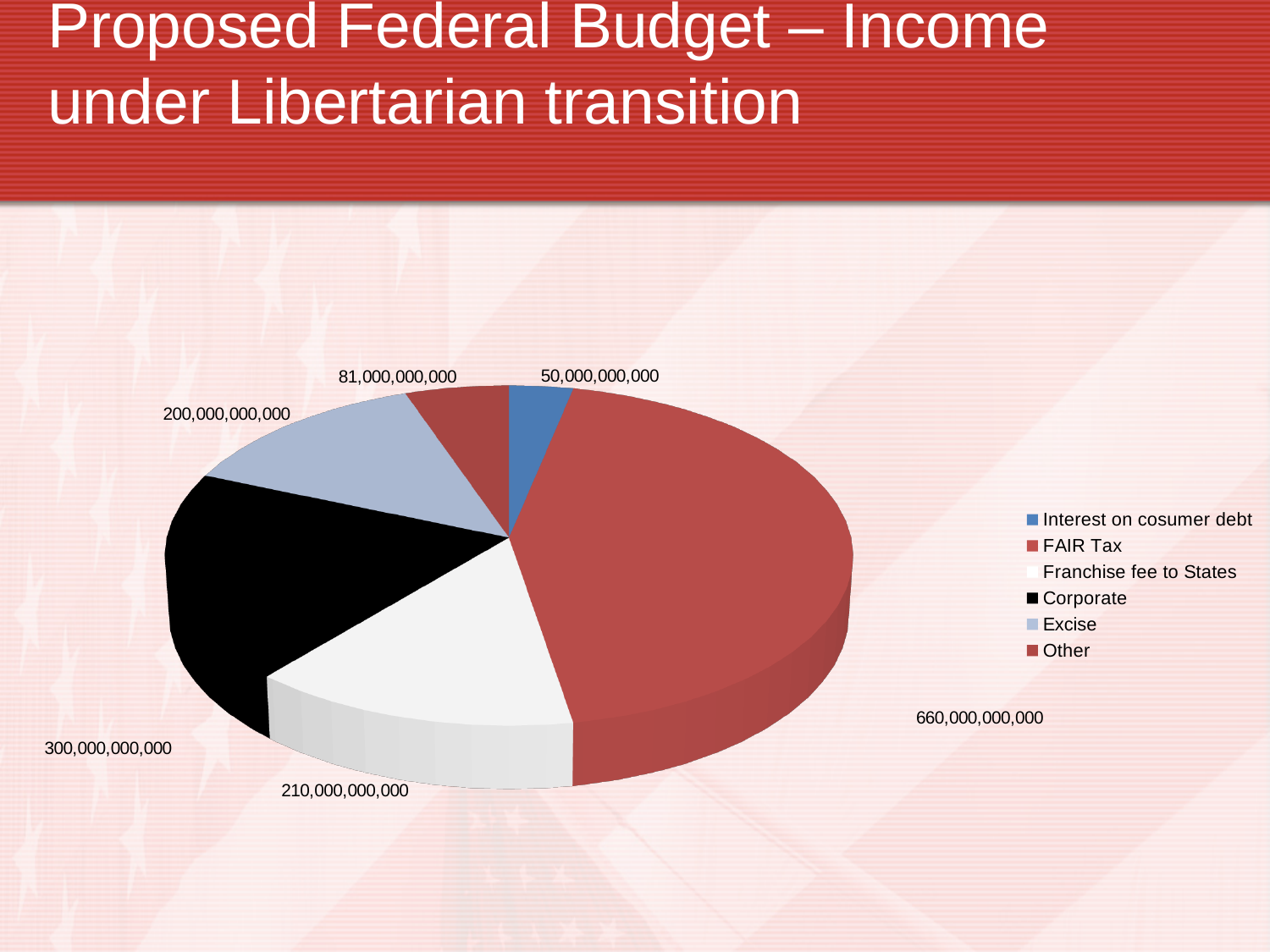
What is the difference between the Corporate value and the Excise value? 100,000,000,000 What kind of chart is shown on the slide? Pie chart How many categories does the legend list? 6 What is the difference between the FAIR Tax value and the Corporate value? 360,000,000,000 What colour is the Corporate slice? Black Which is larger, Franchise fee to States or Excise? Franchise fee to States Which category has the smallest slice of the pie? Interest on cosumer debt What is the value for Excise? 200,000,000,000 What is the value for FAIR Tax? 660,000,000,000 Which category has the largest slice of the pie? FAIR Tax What is the value for Corporate? 300,000,000,000 What is the value for Other? 81,000,000,000